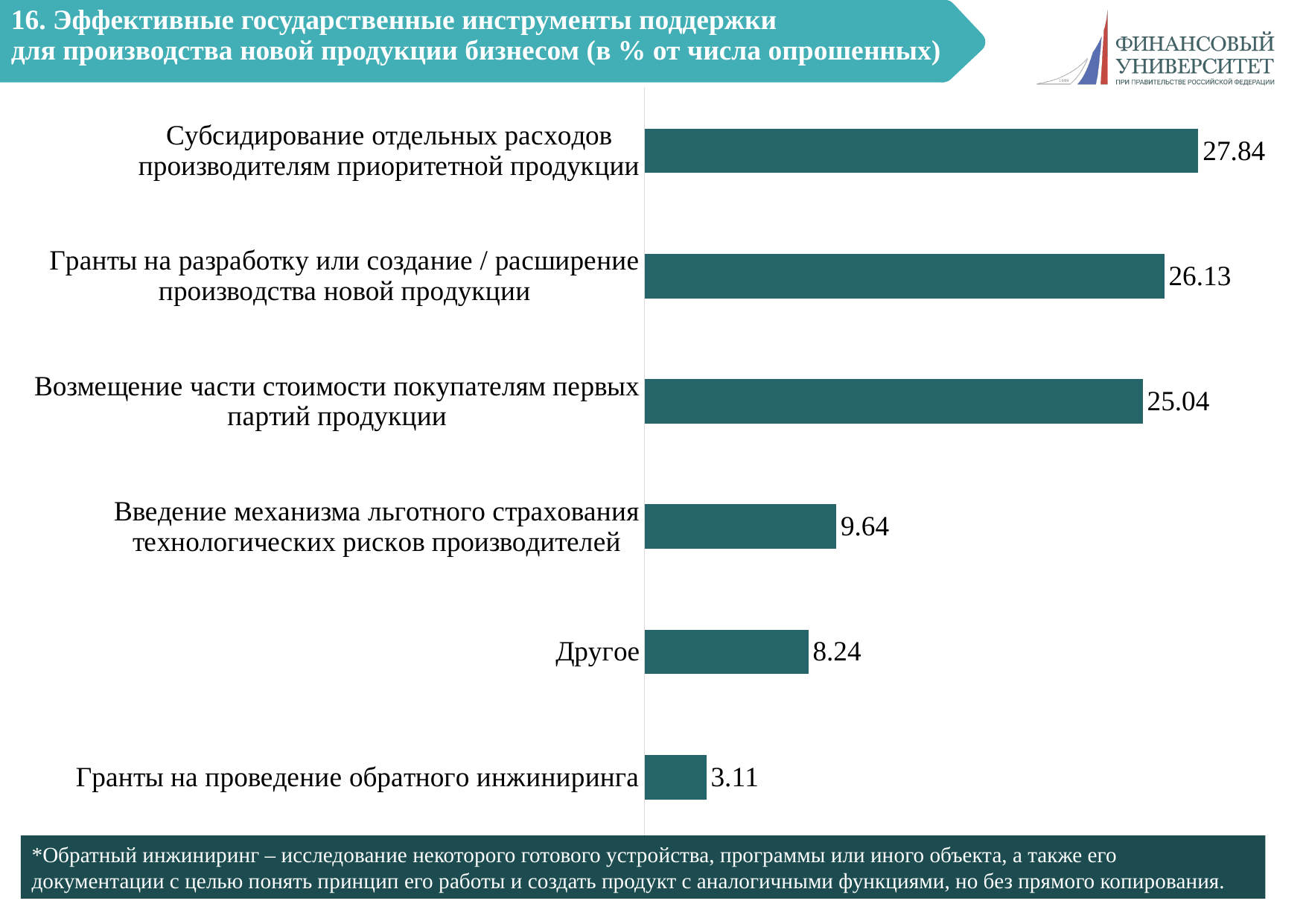
Which category has the lowest value? Гранты на проведение обратного инжиниринга What kind of chart is shown on the slide? Bar chart What is the difference between the values for "Субсидирование отдельных расходов производителям приоритетной продукции" and "Гранты на разработку или создание / расширение производства новой продукции"? 1.71 How many categories are shown in the chart? 6 What is the value for "Другое"? 8.24 Which is larger: the value for "Возмещение части стоимости покупателям первых партий продукции" or the value for "Введение механизма льготного страхования технологических рисков производителей"? Возмещение части стоимости покупателям первых партий продукции Which category has the highest value? Субсидирование отдельных расходов производителям приоритетной продукции What is the value for "Введение механизма льготного страхования технологических рисков производителей"? 9.64 What colour are the bars in the chart? Dark teal What is the value for "Субсидирование отдельных расходов производителям приоритетной продукции"? 27.84 What is the value for "Гранты на проведение обратного инжиниринга"? 3.11 What is the difference between the values for "Введение механизма льготного страхования технологических рисков производителей" and "Другое"? 1.40